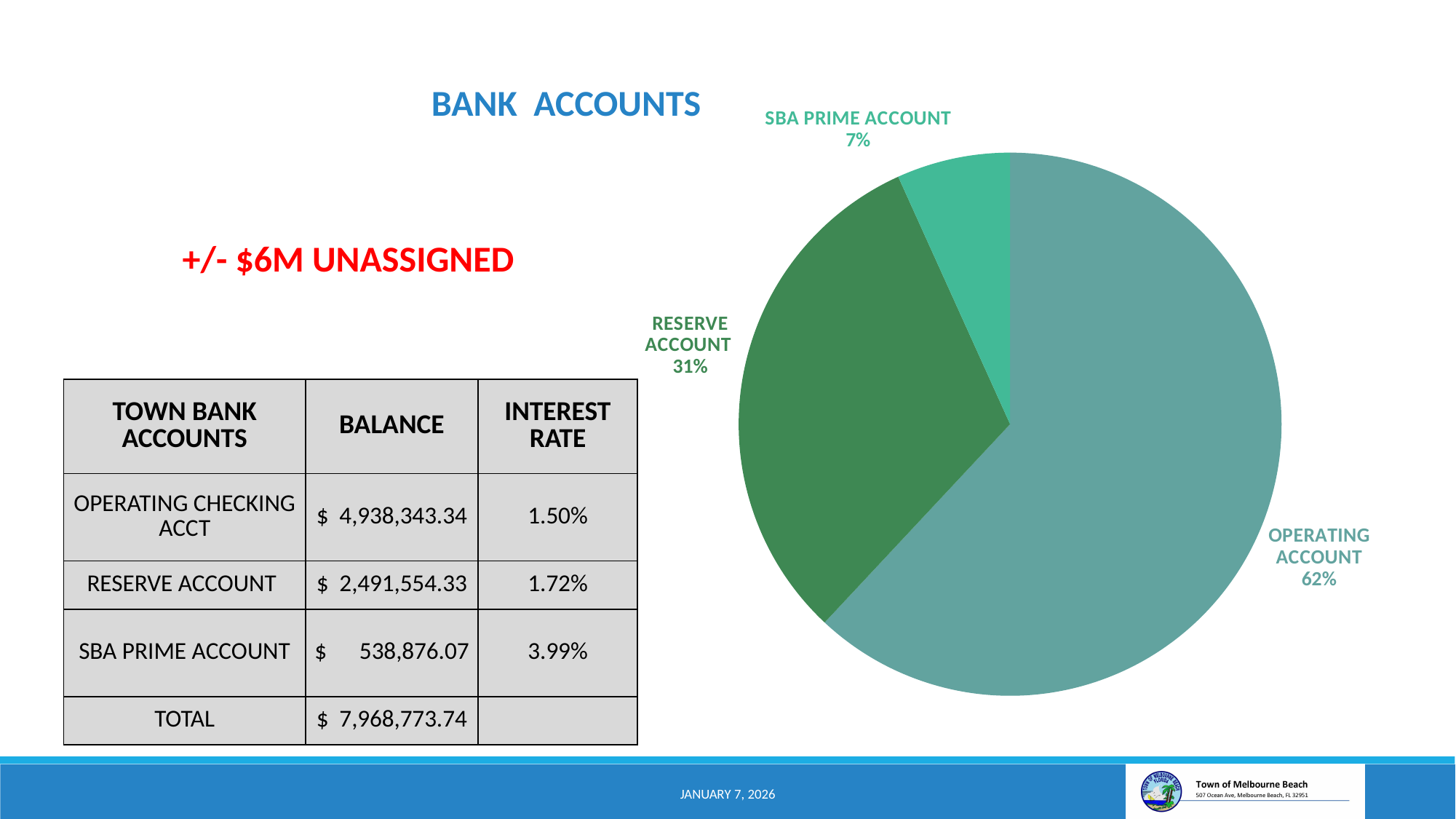
What is the difference in percentage points between the Operating Account slice and the Reserve Account slice? 31 How many slices does the pie chart have? 3 What kind of chart is shown on the slide? pie chart Is the Operating Account slice greater or less than 50% of the pie? greater Which is larger in the pie chart, the Reserve Account slice or the SBA Prime Account slice? Reserve Account Which slice of the pie chart is the largest? Operating Account What is the difference in percentage points between the Reserve Account slice and the SBA Prime Account slice? 24 Which slice of the pie chart is labelled in the darkest green? Reserve Account What share of the pie does the Reserve Account slice represent? 31% Which slice of the pie chart is the smallest? SBA Prime Account What share of the pie does the Operating Account slice represent? 62% What share of the pie does the SBA Prime Account slice represent? 7%